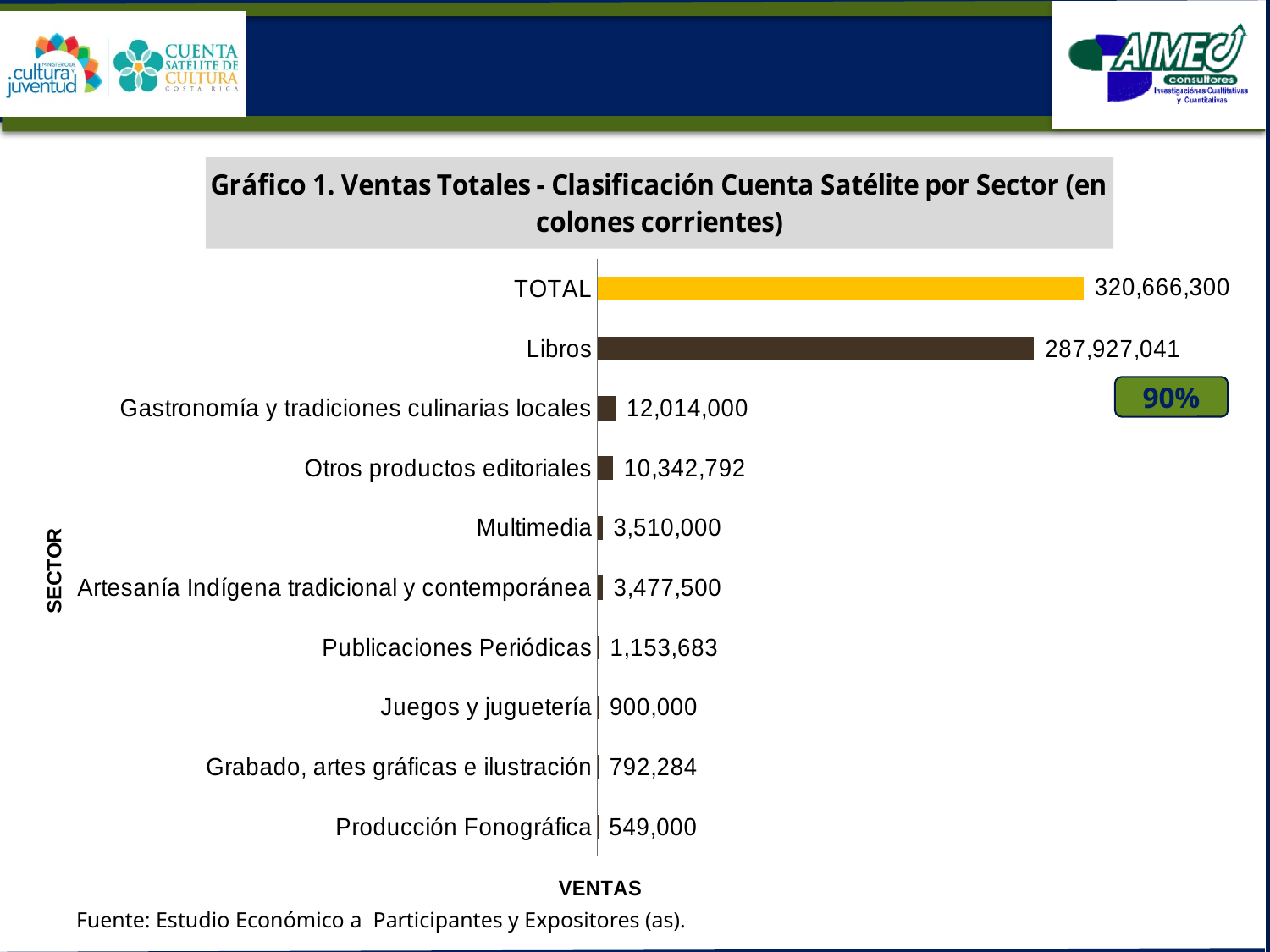
What is the value for Producción Fonográfica? 549,000 What percentage is shown in the green box next to the Libros bar? 90% Excluding the TOTAL bar, which sector has the highest sales? Libros What type of chart is shown on the slide? bar chart What is the value shown for TOTAL? 320,666,300 What is the difference between Gastronomía y tradiciones culinarias locales and Otros productos editoriales? 1,671,208 Which is larger, Multimedia or Publicaciones Periódicas? Multimedia What is the value for Libros? 287,927,041 What is the value for Gastronomía y tradiciones culinarias locales? 12,014,000 Which sector has the lowest sales? Producción Fonográfica What is the difference between Juegos y juguetería and Grabado, artes gráficas e ilustración? 107,716 How many bars are plotted in the chart, including TOTAL? 10